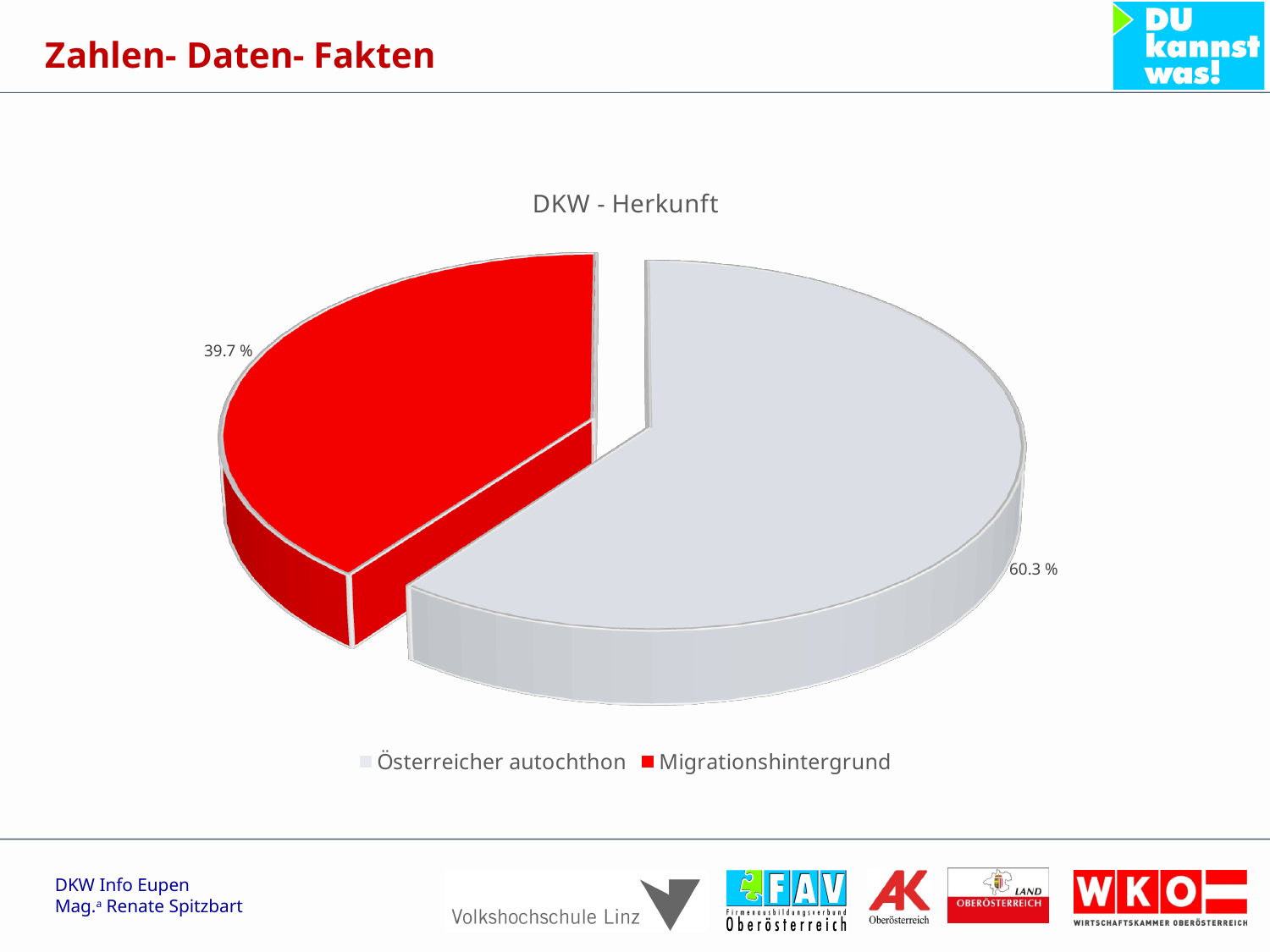
Which is larger, the share for Österreicher autochthon or for Migrationshintergrund? Österreicher autochthon What share of the pie is labelled for Migrationshintergrund? 39.7 % What is the title of the chart? DKW - Herkunft What is the difference in percentage points between Österreicher autochthon and Migrationshintergrund? 20.6 What share of the pie is labelled for Österreicher autochthon? 60.3 % Which category has the smallest share of the pie? Migrationshintergrund What kind of chart is shown on the slide? pie chart What colour is the Migrationshintergrund slice? red What is the total of the two labelled shares? 100 % How many slices does the pie chart have? 2 How many entries does the legend list? 2 Which category has the largest share of the pie? Österreicher autochthon